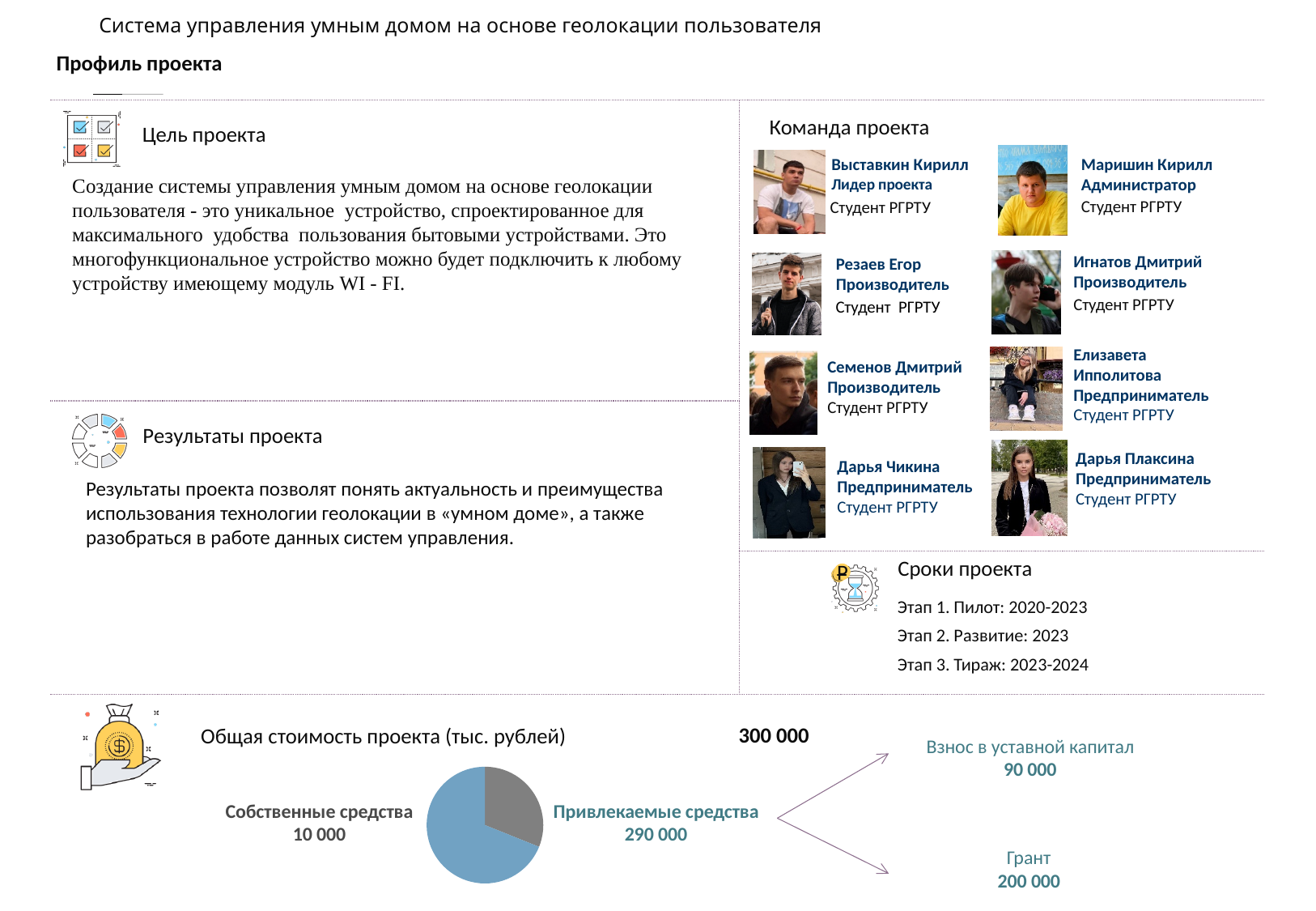
What colour is the "Собственные средства" slice of the pie chart? grey How many slices does the pie chart have? 2 What is the difference between "Привлекаемые средства" and "Собственные средства" in the pie chart? 280 000 What kind of chart is shown at the bottom of the slide under "Общая стоимость проекта (тыс. рублей)"? pie chart What total project cost is shown next to the pie chart title "Общая стоимость проекта (тыс. рублей)"? 300 000 Which slice of the pie chart is the smallest? Собственные средства What colour is the "Привлекаемые средства" slice of the pie chart? blue What is the value labelled for "Собственные средства" in the pie chart? 10 000 According to the breakdown to the right of the pie chart, what value is shown for "Грант"? 200 000 Which is larger in the pie chart, "Собственные средства" or "Привлекаемые средства"? Привлекаемые средства Which slice of the pie chart is the largest? Привлекаемые средства What is the value labelled for "Привлекаемые средства" in the pie chart? 290 000